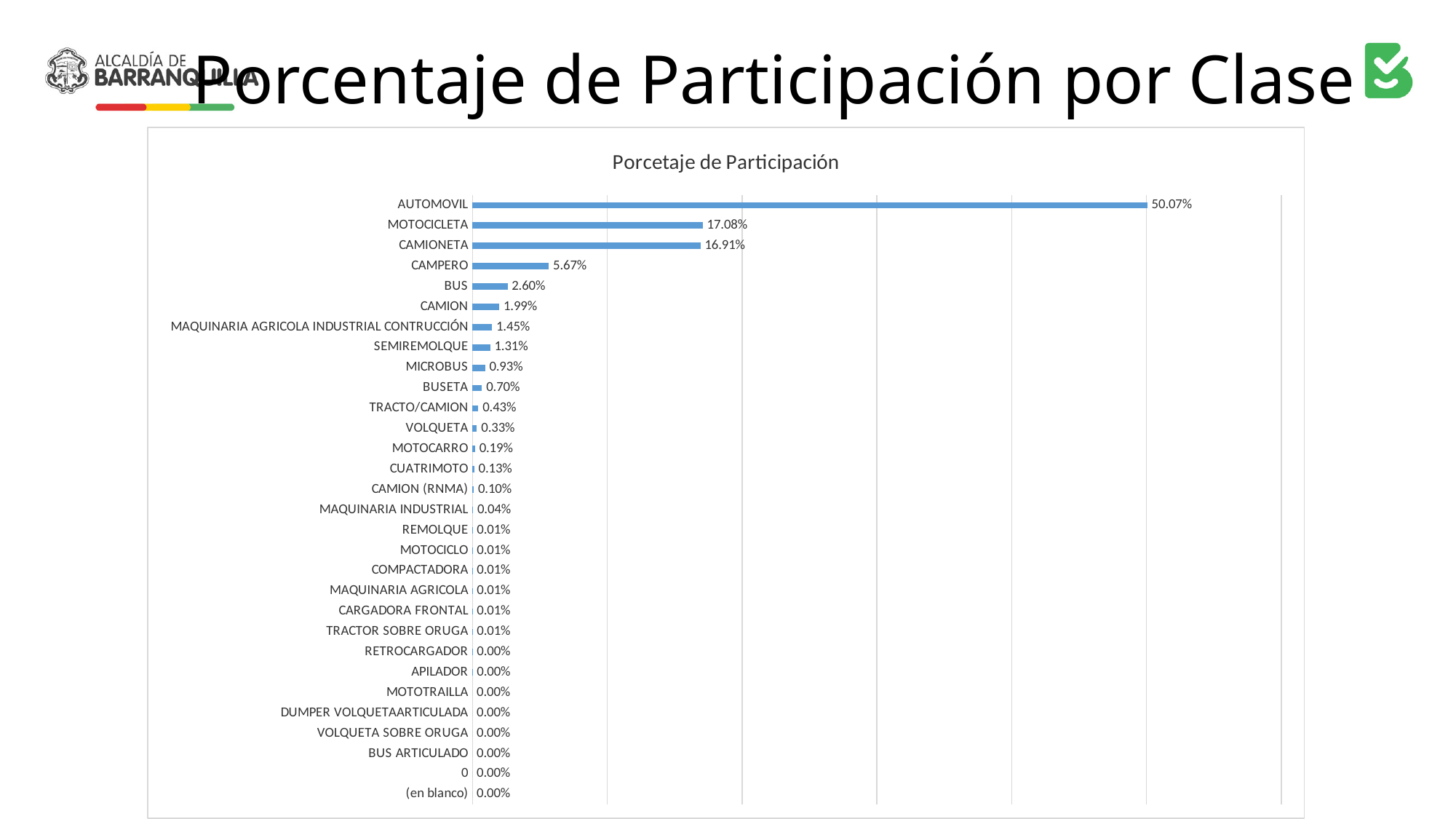
Which category has the highest value? AUTOMOVIL Which is larger, the value for BUS or the value for CAMION? BUS What is the value for SEMIREMOLQUE? 1.31% What is the title of the chart? Porcetaje de Participación What is the value for AUTOMOVIL? 50.07% What is the difference between the values for AUTOMOVIL and MOTOCICLETA? 32.99% How many categories are shown on the chart? 30 What is the value for MICROBUS? 0.93% What kind of chart is shown on the slide? bar chart What is the value for CAMPERO? 5.67% What is the value for MOTOCICLETA? 17.08% What is the difference between the values for MOTOCICLETA and CAMIONETA? 0.17%